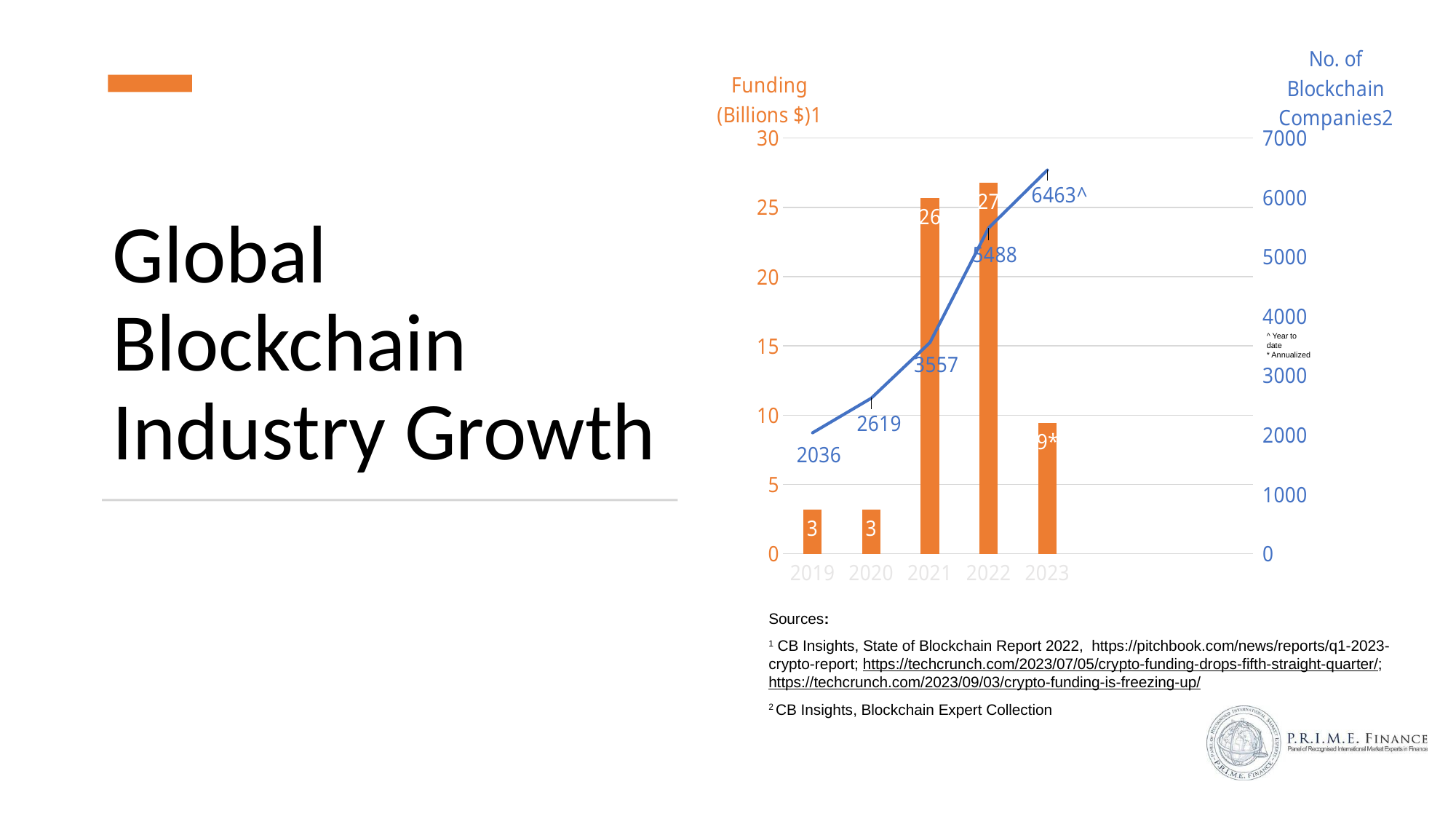
How many years are shown on the x axis of the chart? 5 Which year has the highest funding (Billions $) bar? 2022 What is the difference in funding (Billions $) between 2022 and 2019? 24 What is the number of blockchain companies shown for 2020? 2619 What is the funding value (Billions $) shown for 2023? 9* What is the funding value (Billions $) shown for 2021? 26 What is the label of the left-hand vertical axis of the chart? Funding (Billions $)1 What is the difference in the number of blockchain companies between 2022 and 2021? 1931 Which year has more blockchain companies, 2021 or 2022? 2022 Does the number of blockchain companies rise or fall from 2019 to 2023? rise What is the number of blockchain companies shown for 2023? 6463^ Which year has the lowest number of blockchain companies? 2019